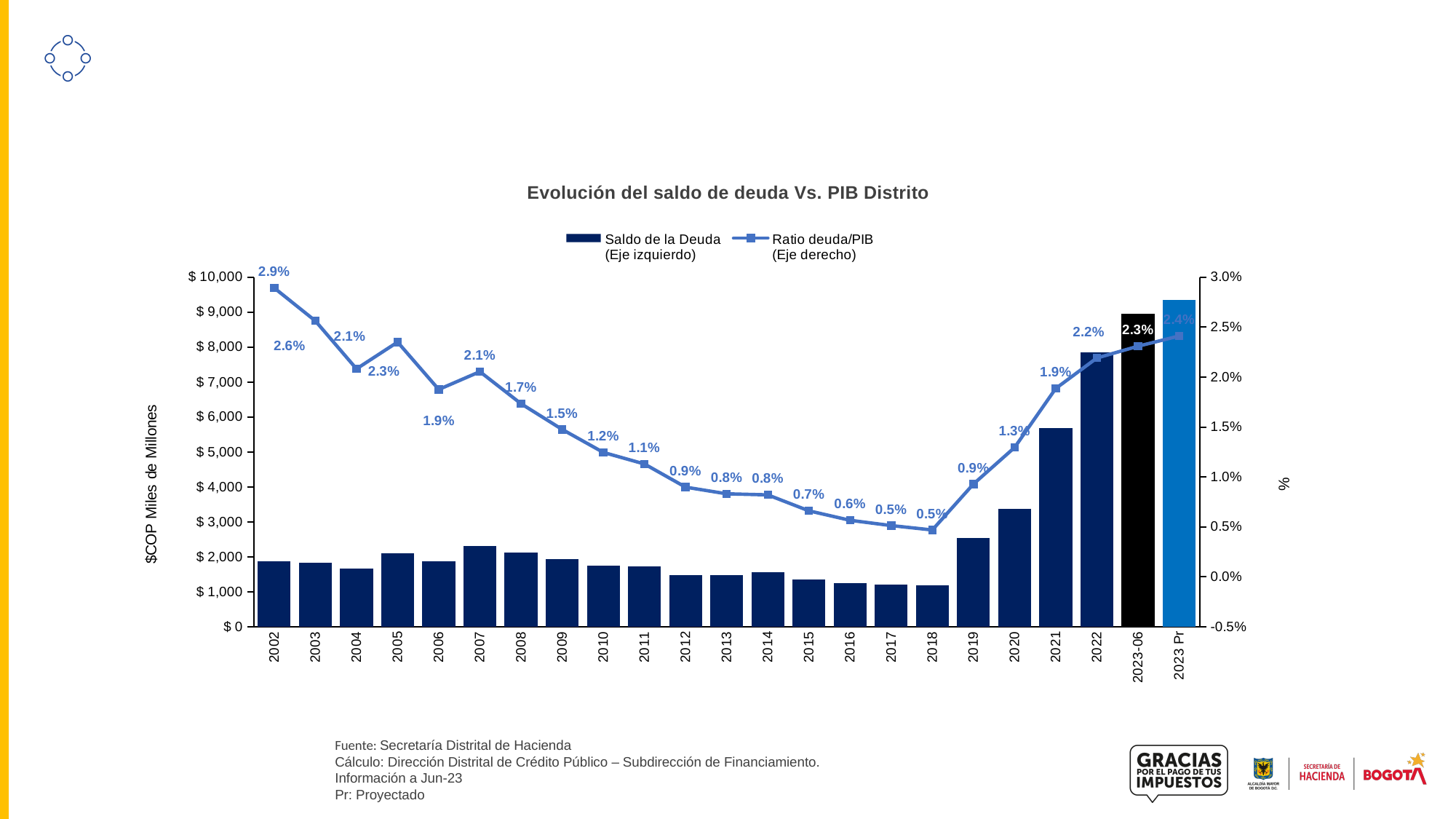
How many series does the legend list? 2 In which year is the Ratio deuda/PIB highest? 2002 What is the Ratio deuda/PIB value for 2010? 1.2% What is the lowest Ratio deuda/PIB value shown on the chart? 0.5% Is the Saldo de la Deuda bar for 2023 Pr greater or less than $ 9,000? greater Is the Saldo de la Deuda bar for 2018 greater or less than $ 2,000? less Which is larger, the Ratio deuda/PIB for 2020 or for 2016? 2020 How many year categories are shown on the x axis? 23 By how many percentage points does the Ratio deuda/PIB for 2002 exceed the value for 2023 Pr? 0.5 percentage points What is the Ratio deuda/PIB value for 2023 Pr? 2.4% Does the Ratio deuda/PIB rise or fall from 2002 to 2018? fall What is the Ratio deuda/PIB value for 2002? 2.9%